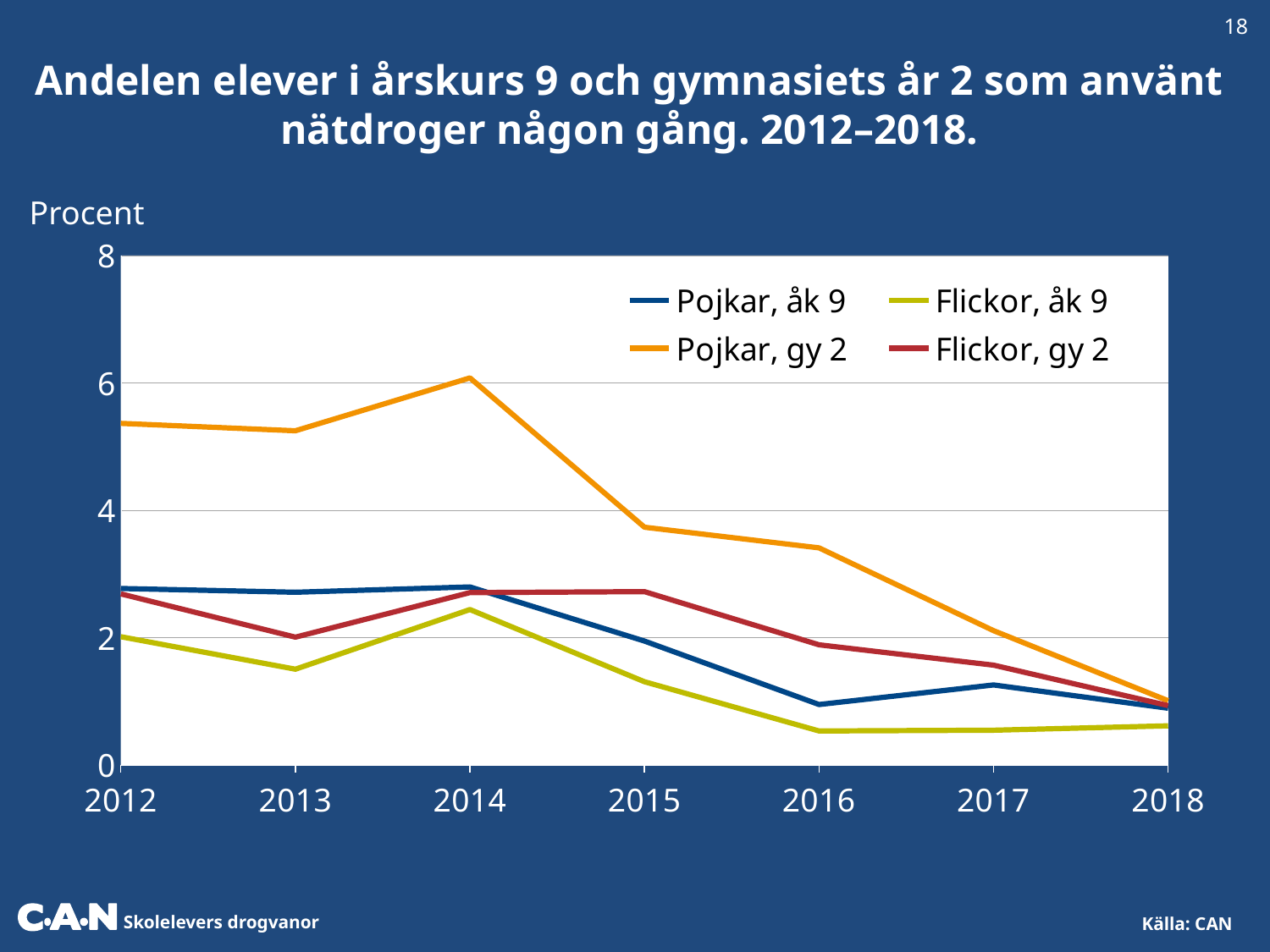
In which year does the Pojkar, gy 2 series reach its highest value? 2014 How many series does the legend list? 4 Is the value for Flickor, åk 9 in 2016 greater or less than 2? less Does the Pojkar, gy 2 series rise or fall overall from 2014 to 2018? fall What kind of chart is shown on the slide? line chart What unit label is shown above the y axis? Procent Is the value for Pojkar, åk 9 in 2013 greater or less than 2? greater How many years are plotted along the x axis? 7 Which series has the highest value in 2014? Pojkar, gy 2 Which series has the lowest value in 2016? Flickor, åk 9 Is the value for Pojkar, gy 2 in 2012 greater or less than 4? greater In 2015, which is larger: the value for Pojkar, gy 2 or the value for Flickor, åk 9? Pojkar, gy 2